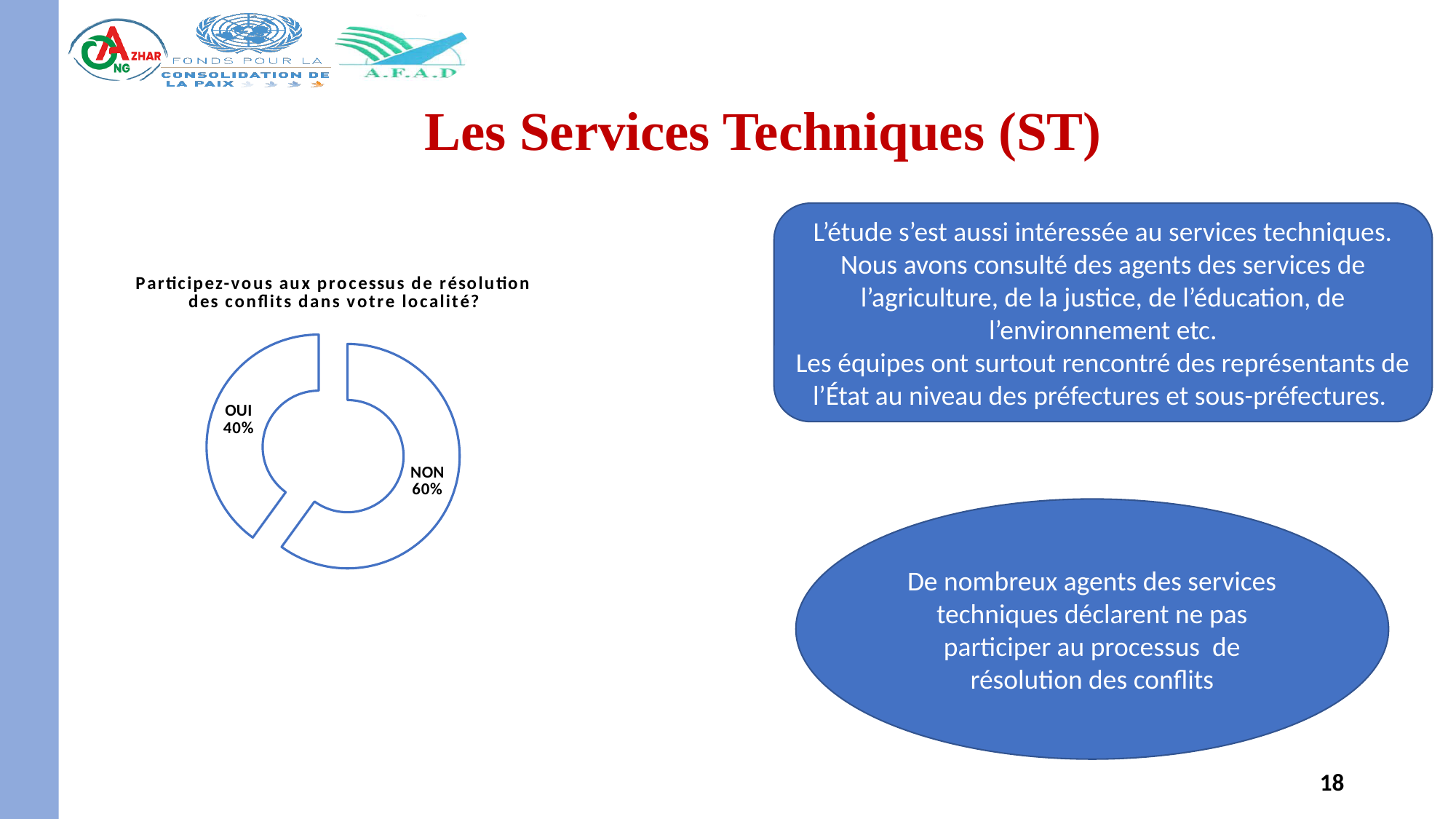
What is the total of the two shares shown in the chart? 100% Is the share for NON greater or less than 50%? greater What percentage of respondents answered NON in the doughnut chart? 60% Is the share for OUI larger or smaller than the share for NON? smaller What is the difference in percentage points between the NON and OUI shares? 20 Which response has the smaller share in the chart? OUI Which response has the larger share in the chart, OUI or NON? NON What percentage of respondents answered OUI to the question about participating in conflict resolution processes? 40% How many categories are shown in the chart? 2 What type of chart is shown on the slide? doughnut (pie) chart What is the title of the chart? Participez-vous aux processus de résolution des conflits dans votre localité?